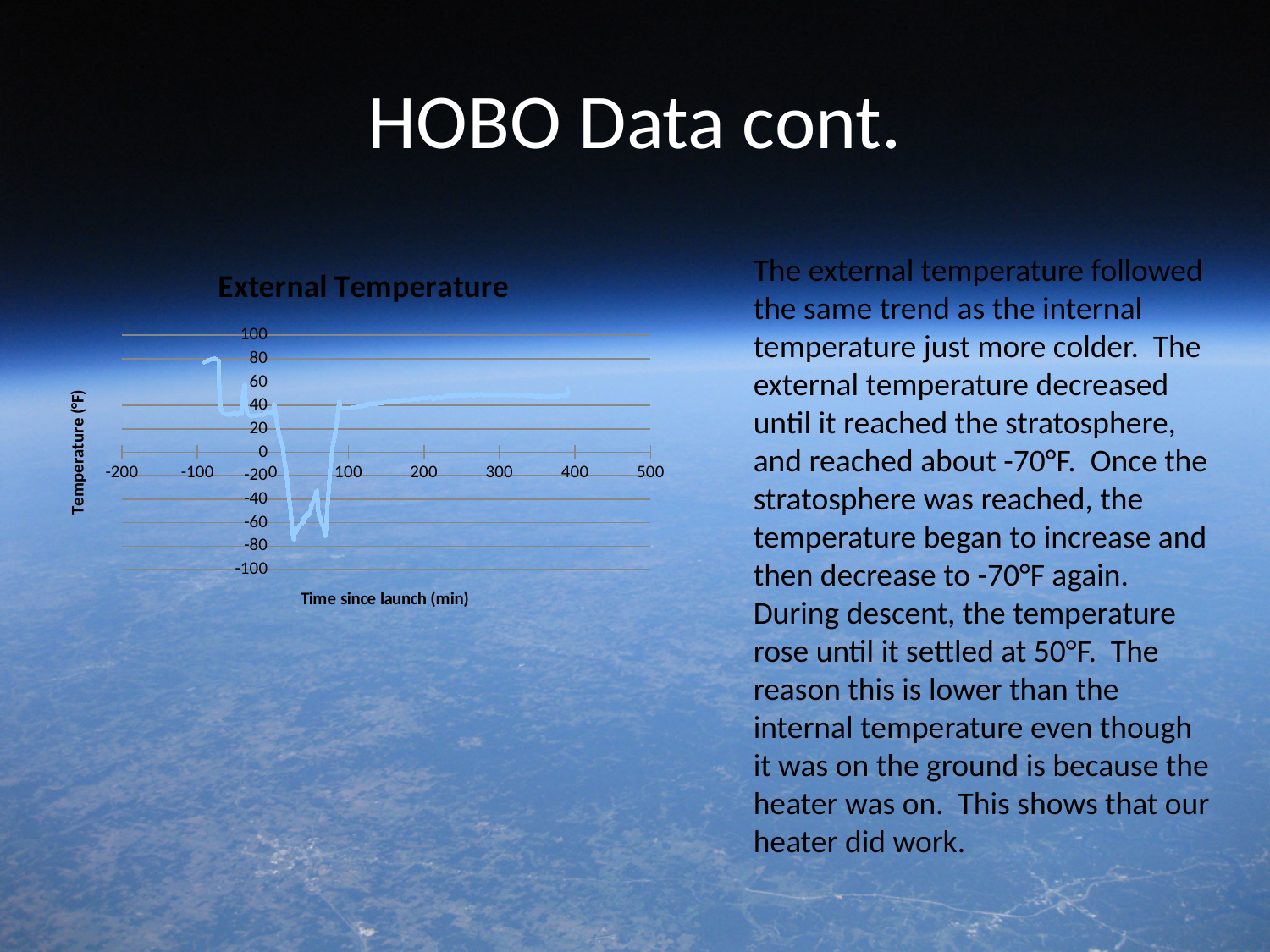
Is the temperature at 100 minutes since launch greater or less than 0? greater Is the temperature at 300 minutes since launch greater or less than 20? greater Is the lowest temperature reached on the chart greater or less than -40? less What is the title of the chart? External Temperature Immediately after time 0 (launch), does the temperature rise or fall? fall What is the label on the vertical axis of the chart? Temperature (°F) Between 100 and 300 minutes since launch, does the temperature generally rise or fall? rise What kind of chart is shown on the slide? line chart